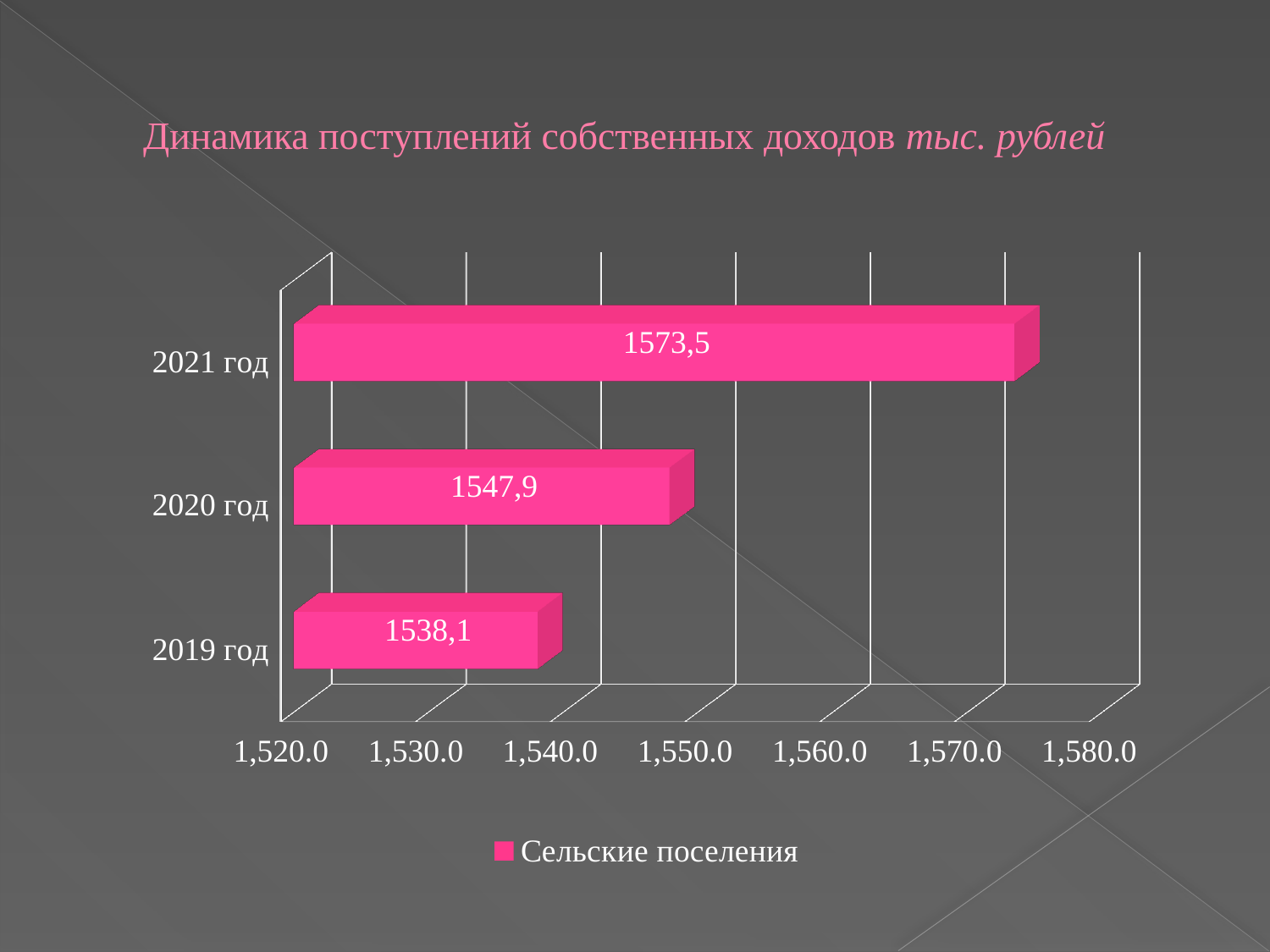
What is the value for 2019 год? 1538,1 How many years are shown in the chart? 3 What is the value for 2021 год? 1573,5 What is the difference between the values for 2021 год and 2020 год? 25,6 What is the value for 2020 год? 1547,9 What is the difference between the values for 2020 год and 2019 год? 9,8 Which year has the highest value? 2021 год What kind of chart is shown on the slide? bar chart What series does the legend list? Сельские поселения Is the value for 2021 год greater or less than 1,570.0? greater Which year has the lowest value? 2019 год Which is larger, the value for 2020 год or the value for 2019 год? 2020 год